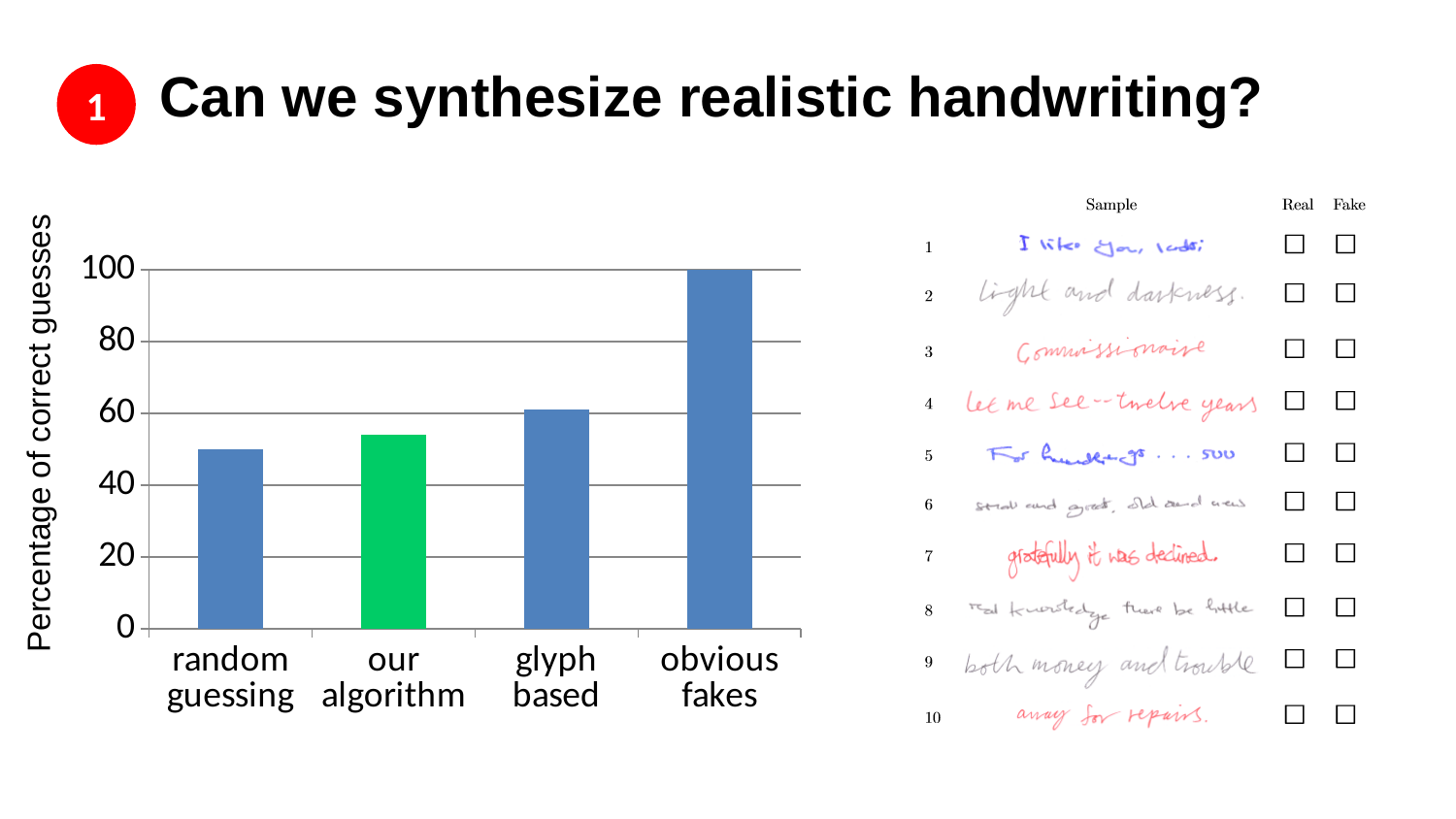
Is the value for our algorithm greater or less than 40? greater What is the percentage of correct guesses for obvious fakes? 100 Which category has the lowest percentage of correct guesses? random guessing Is the value for random guessing greater or less than 60? less Do the values rise or fall from left to right along the x axis? rise What colour is the bar for our algorithm? green Is the value for our algorithm greater or less than 80? less What is the label on the y axis of the chart? Percentage of correct guesses What kind of chart is shown on the slide? bar chart Which category has the highest percentage of correct guesses? obvious fakes Which has a higher percentage of correct guesses, glyph based or random guessing? glyph based How many categories are shown on the x axis of the bar chart? 4